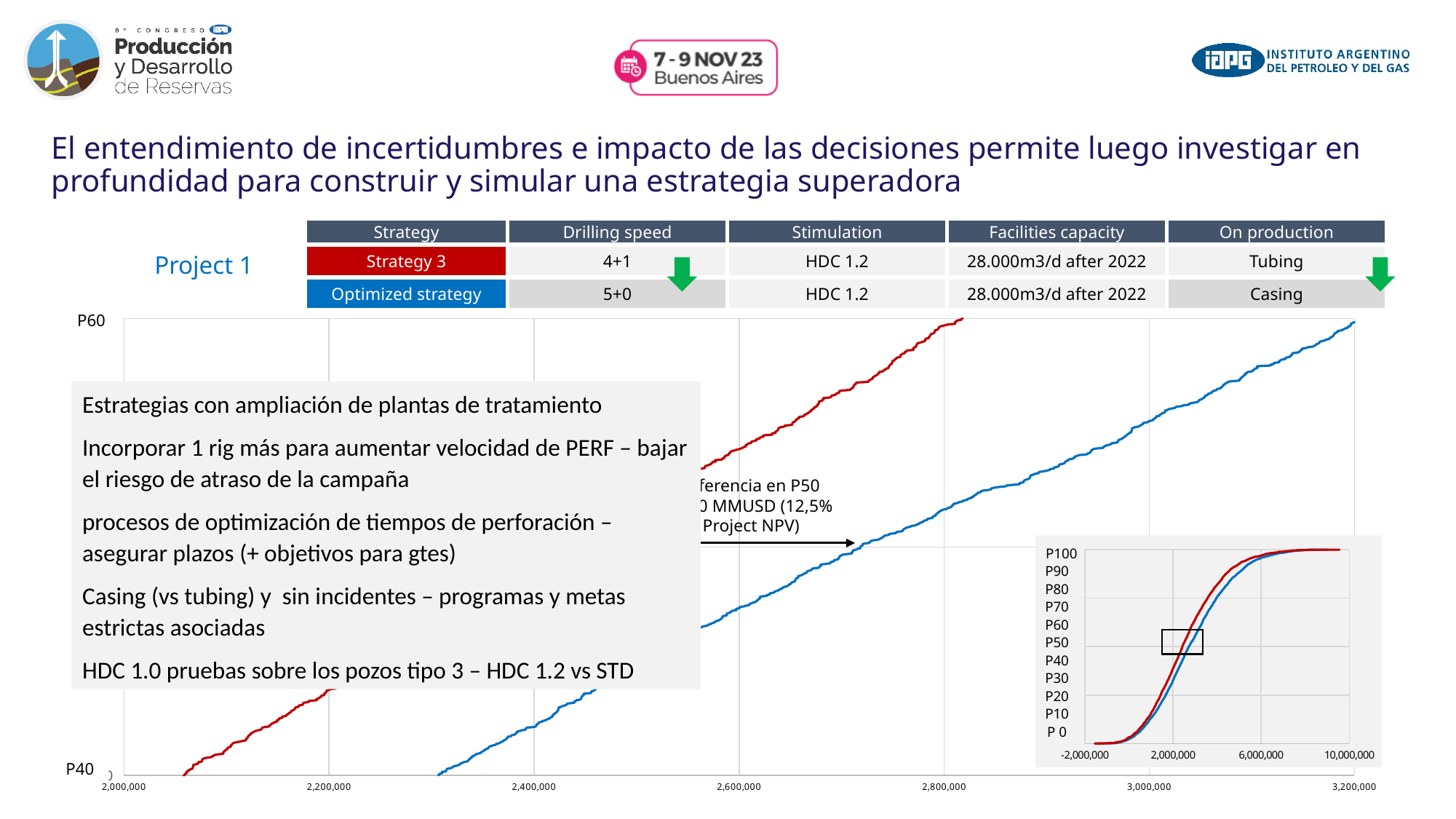
On the large chart, which line reaches the P60 level at a lower x-axis value, the red line or the blue line? the red line What is the highest x-axis tick label on the large chart? 3,200,000 On the large chart, which line lies further to the right, the red line or the blue line? the blue line On the small inset chart, what is the highest x-axis tick label? 10,000,000 On the large chart, is the x-axis value where the blue line crosses the P50 level greater or less than 2,600,000? greater What are the top and bottom y-axis labels on the large chart? P60 and P40 What is the lowest x-axis tick label on the large chart? 2,000,000 What kind of chart is the large chart on the slide? line chart How many x-axis tick labels are shown on the large chart? 7 On the large chart, do the lines rise or fall as the x-axis value increases? rise On the small inset chart, what is the lowest x-axis tick label? -2,000,000 How many lines are plotted on the large chart? 2